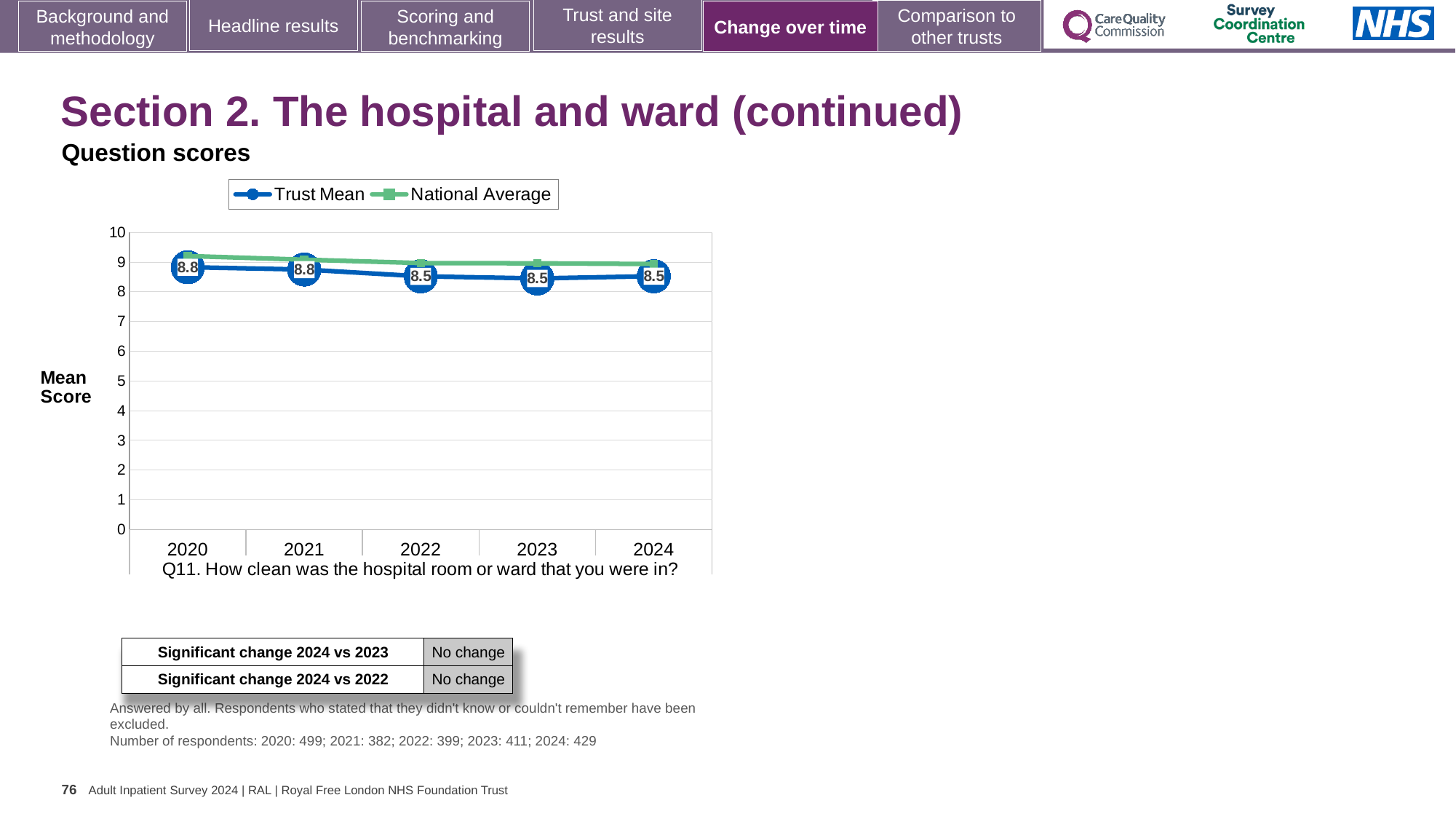
Which question does the chart show scores for? Q11. How clean was the hospital room or ward that you were in? How many series does the chart legend list? 2 What is the difference between the Trust Mean score in 2020 and in 2024? 0.3 What is the label on the vertical axis of the chart? Mean Score Which is larger in 2023, the Trust Mean or the National Average? National Average What is the Trust Mean score for 2022? 8.5 Is the National Average value for 2020 greater or less than 8? greater What kind of chart is shown on the slide? Line chart What is the Trust Mean score for 2024? 8.5 What is the Trust Mean score for 2020? 8.8 How many years are shown on the x axis of the chart? 5 Does the Trust Mean rise or fall from 2020 to 2024? Fall